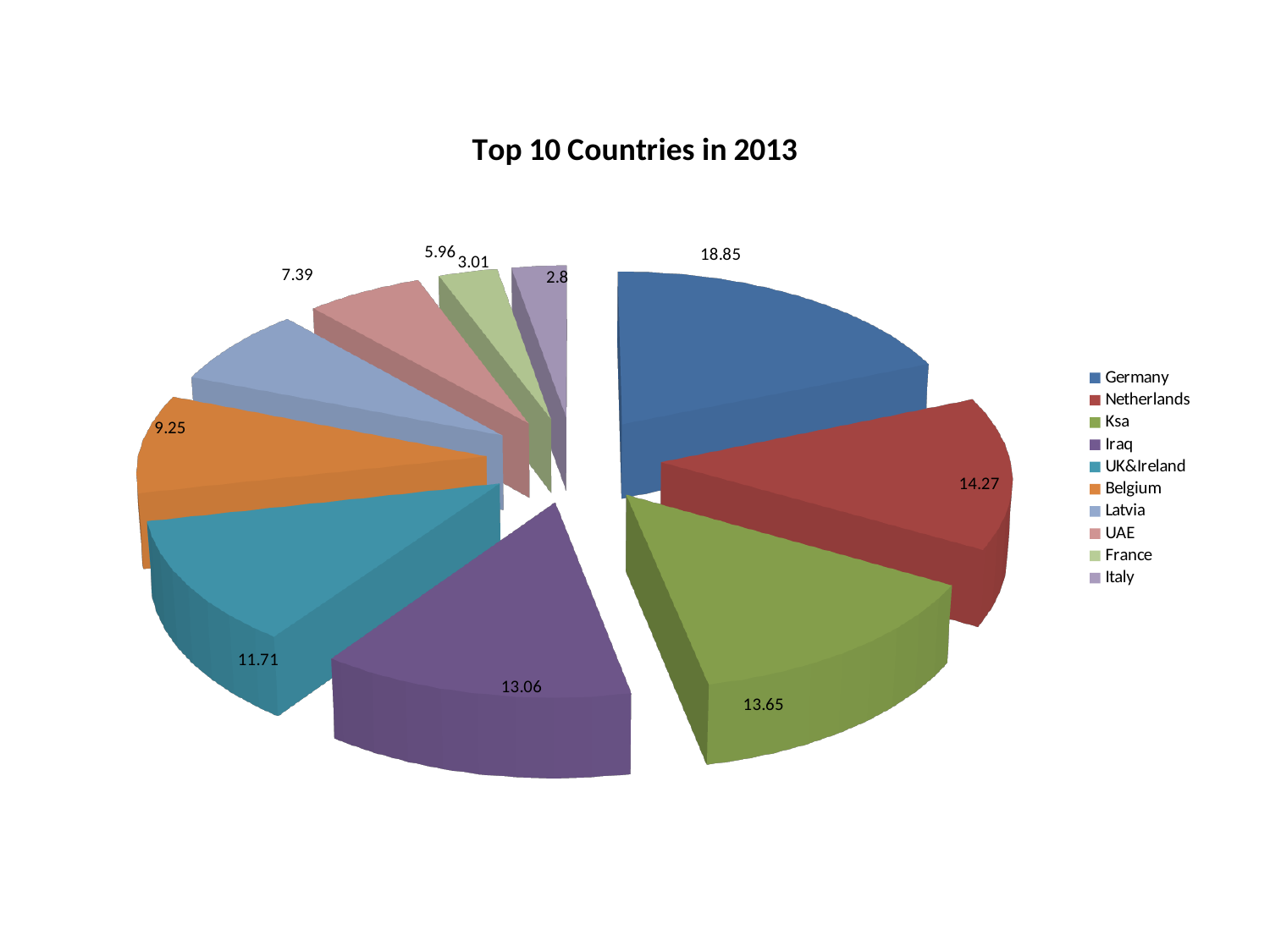
Which country has the largest slice? Germany Which country has the smallest slice? Italy What is the difference between the values for Germany and Netherlands? 4.58 What type of chart is shown on the slide? Pie chart Which is larger, the value for Ksa or the value for Iraq? Ksa What is the value for Netherlands? 14.27 What is the value for Latvia? 7.39 What is the value for Germany? 18.85 What is the value for UK&Ireland? 11.71 What is the title of the chart? Top 10 Countries in 2013 What is the difference between the values for UK&Ireland and Belgium? 2.46 How many countries are shown in the pie chart? 10